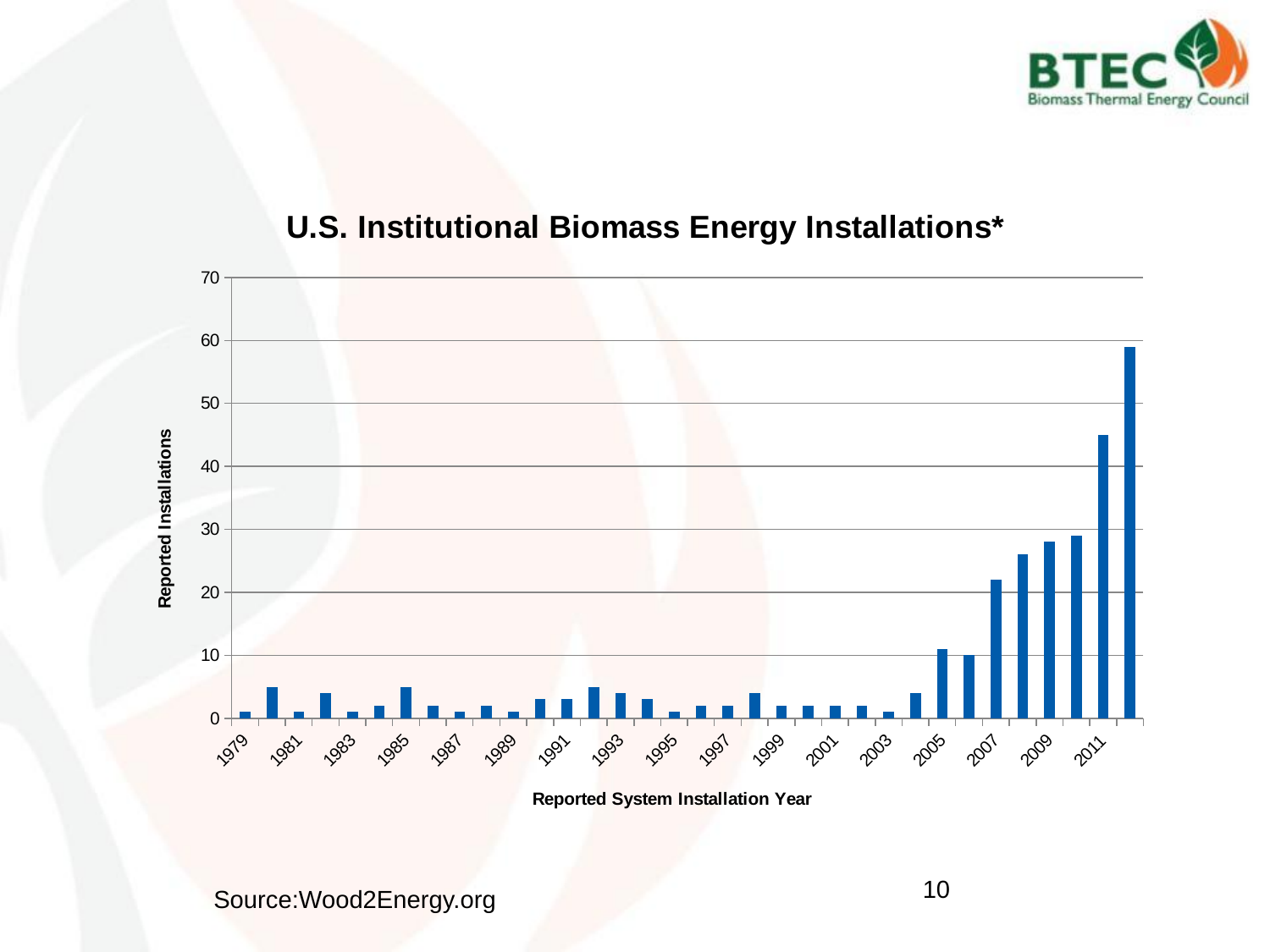
Is the value for 2005 greater or less than 20? less What is the title of the chart? U.S. Institutional Biomass Energy Installations* Which year has the larger value, 1979 or 1985? 1985 What kind of chart is shown on the slide? bar chart What is the label on the vertical axis of the chart? Reported Installations Do the values generally rise or fall from 2005 to 2011? rise Which year has the larger value, 2011 or 2009? 2011 Is the value for 2009 greater or less than 30? less Which year has the larger value, 2007 or 2005? 2007 Is the value for 2007 greater or less than 20? greater